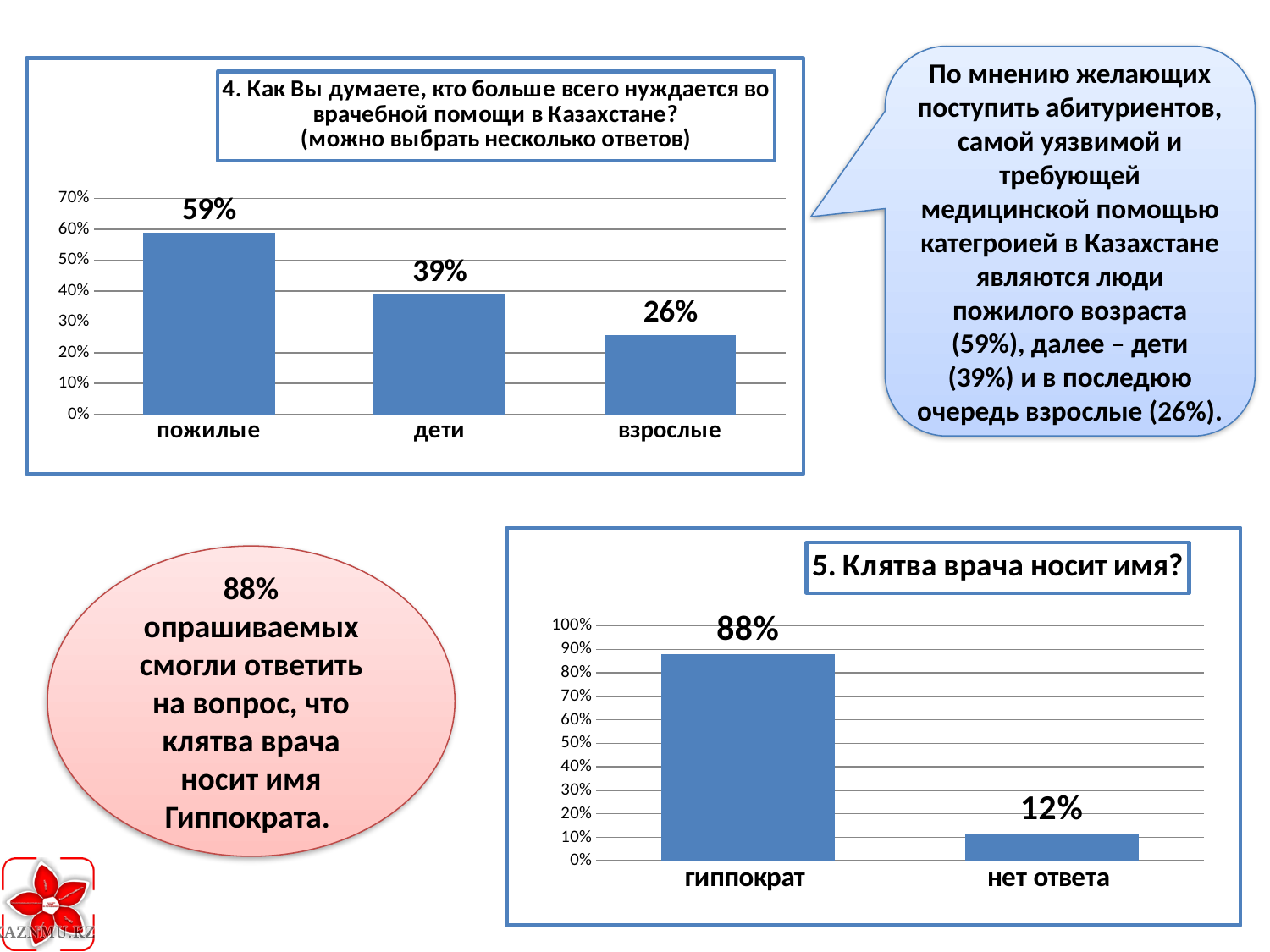
In the top chart (question 4, who most needs medical help in Kazakhstan), what is the value for пожилые? 59% In the top chart (question 4), do the values rise or fall from left to right? fall In the bottom chart (question 5), what is the difference between гиппократ and нет ответа? 76% In the top chart (question 4), how many categories are shown? 3 What type of chart is the bottom chart (question 5)? bar chart In the bottom chart (question 5), what is the value for нет ответа? 12% In the bottom chart (question 5, Клятва врача носит имя?), what is the value for гиппократ? 88% In the top chart (question 4), which category has the lowest value? взрослые In the top chart (question 4), what is the value for дети? 39% In the top chart (question 4), which category has the highest value? пожилые In the bottom chart (question 5), which is larger: гиппократ or нет ответа? гиппократ In the top chart (question 4), what is the difference between the values for пожилые and взрослые? 33%